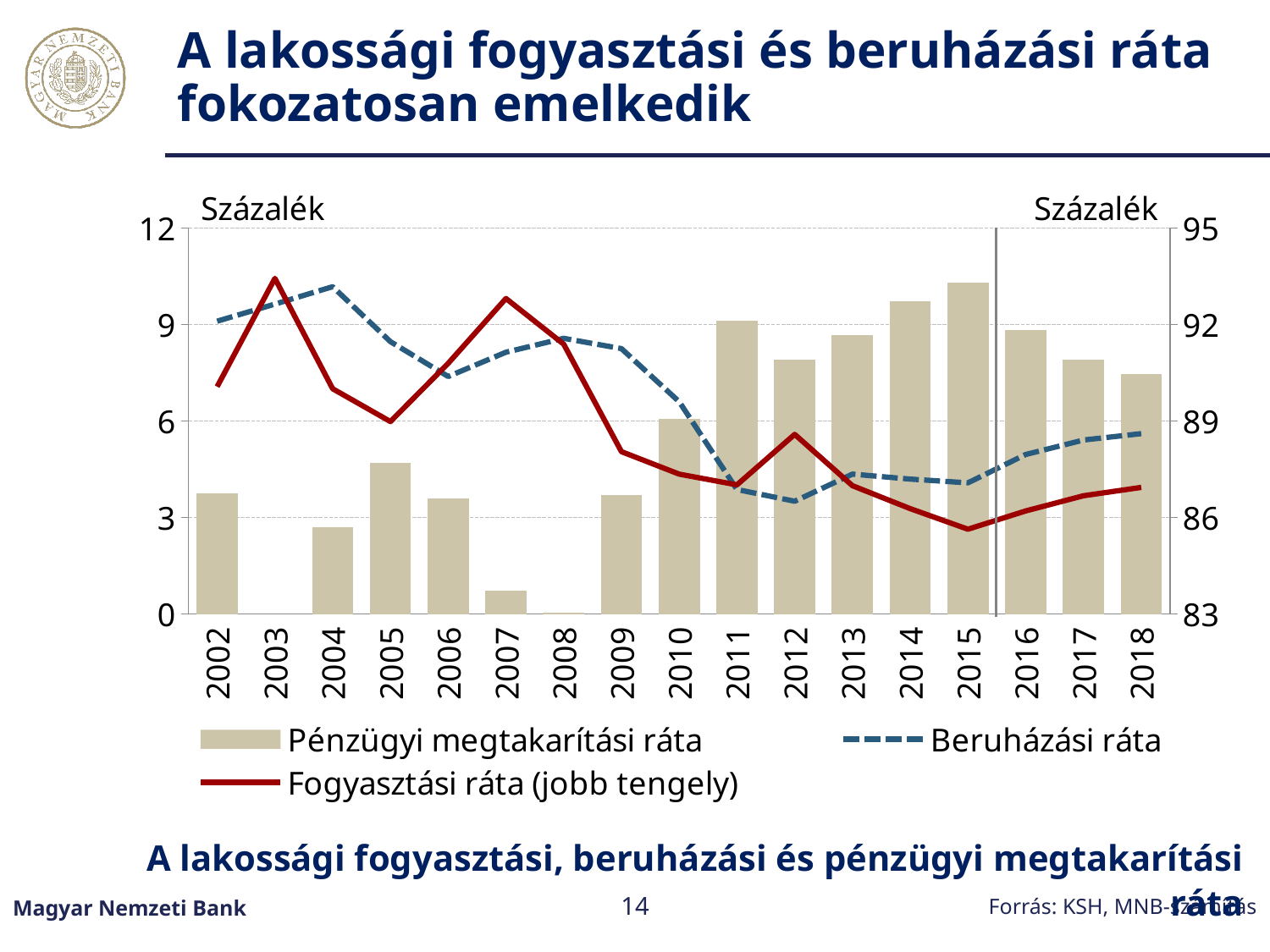
Do the Pénzügyi megtakarítási ráta bars rise or fall from 2015 to 2018? fall Which series is plotted on the right axis according to the legend? Fogyasztási ráta (jobb tengely) How many series does the legend list? 3 What type of chart is shown on the slide? A combined bar and line chart In which year is the Pénzügyi megtakarítási ráta bar the highest? 2015 Is the Pénzügyi megtakarítási ráta bar for 2007 greater or less than 3? less Is the Fogyasztási ráta value for 2003 greater or less than 92 on the right axis? greater How many years are shown on the x axis? 17 Is the Pénzügyi megtakarítási ráta bar for 2014 greater or less than 9? greater Which year has the larger Pénzügyi megtakarítási ráta bar, 2014 or 2016? 2014 In which year does the Fogyasztási ráta line reach its lowest point? 2015 In which year is the Pénzügyi megtakarítási ráta bar the lowest? 2003